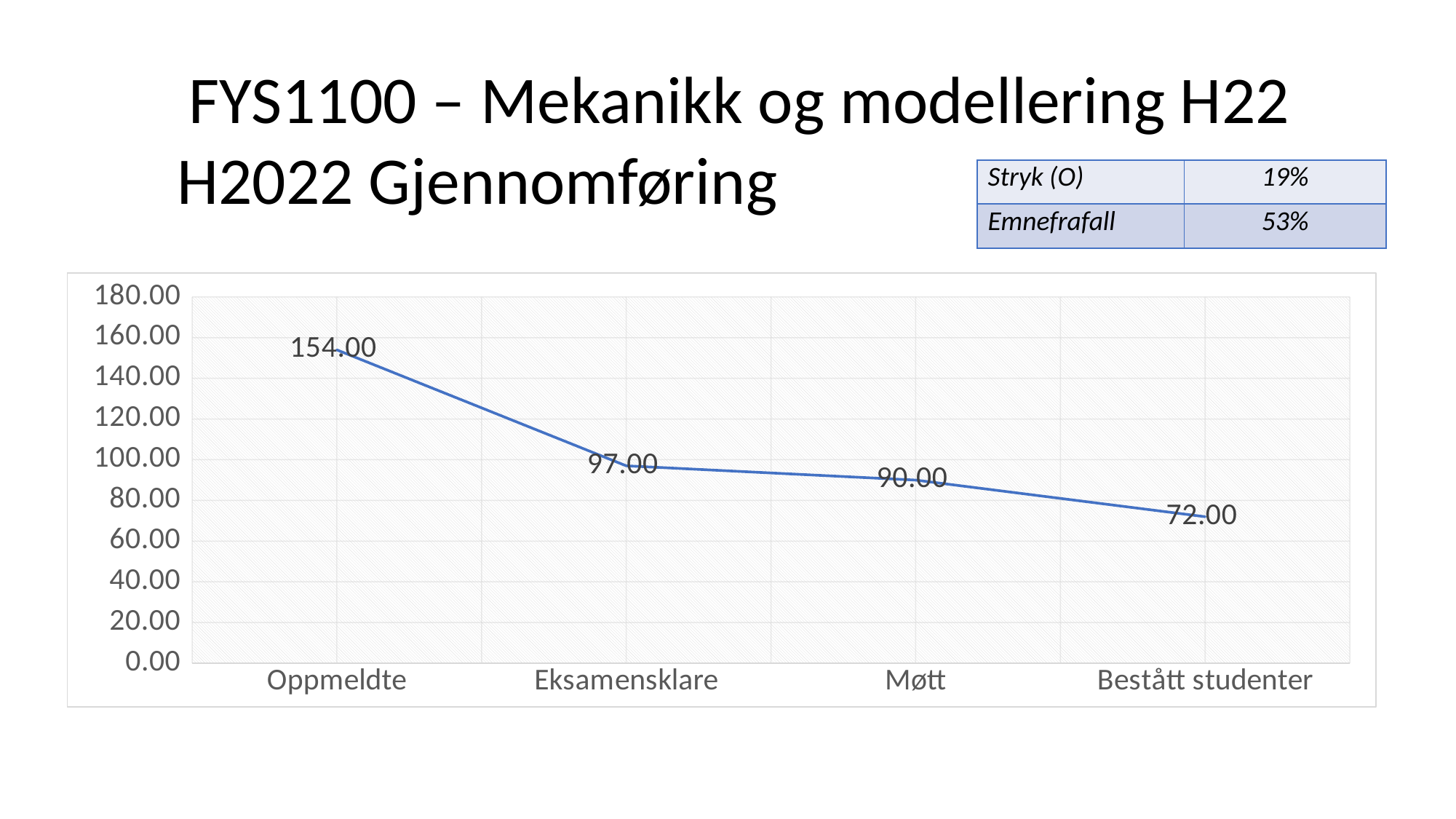
Which is larger, the value for Eksamensklare or the value for Møtt? Eksamensklare What is the value for Eksamensklare? 97.00 What is the value for Oppmeldte? 154.00 What is the difference between the values for Møtt and Bestått studenter? 18.00 What is the value for Bestått studenter? 72.00 Which category has the lowest value? Bestått studenter What is the value for Møtt? 90.00 What kind of chart is shown on the slide? Line chart How many categories are plotted on the x axis? 4 Which category has the highest value? Oppmeldte Do the values rise or fall from Oppmeldte to Bestått studenter? Fall What is the difference between the values for Oppmeldte and Eksamensklare? 57.00